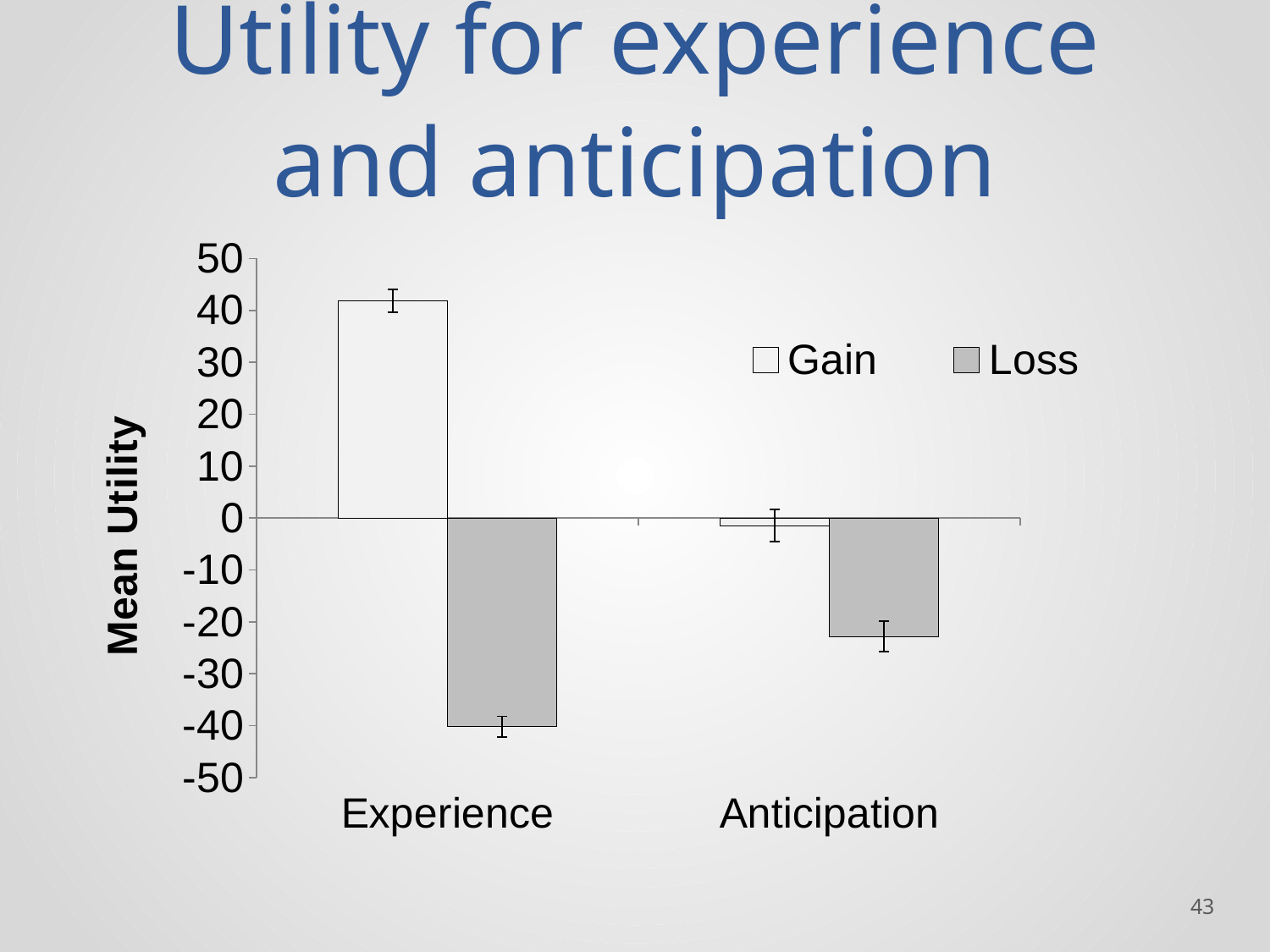
Does the Gain series rise or fall from Experience to Anticipation? fall Is the Loss value for Experience greater or less than -30? less What kind of chart is shown on the slide? bar chart How many series does the legend list? 2 Which bar has the lowest value in the chart? Loss for Experience Which bar has the highest value in the chart? Gain for Experience How many categories are shown on the x axis? 2 Is the Loss value for Anticipation greater or less than -30? greater Is the Gain value for Anticipation greater or less than 10? less Which is larger, the Gain value for Experience or the Gain value for Anticipation? Experience What is the label on the y axis? Mean Utility